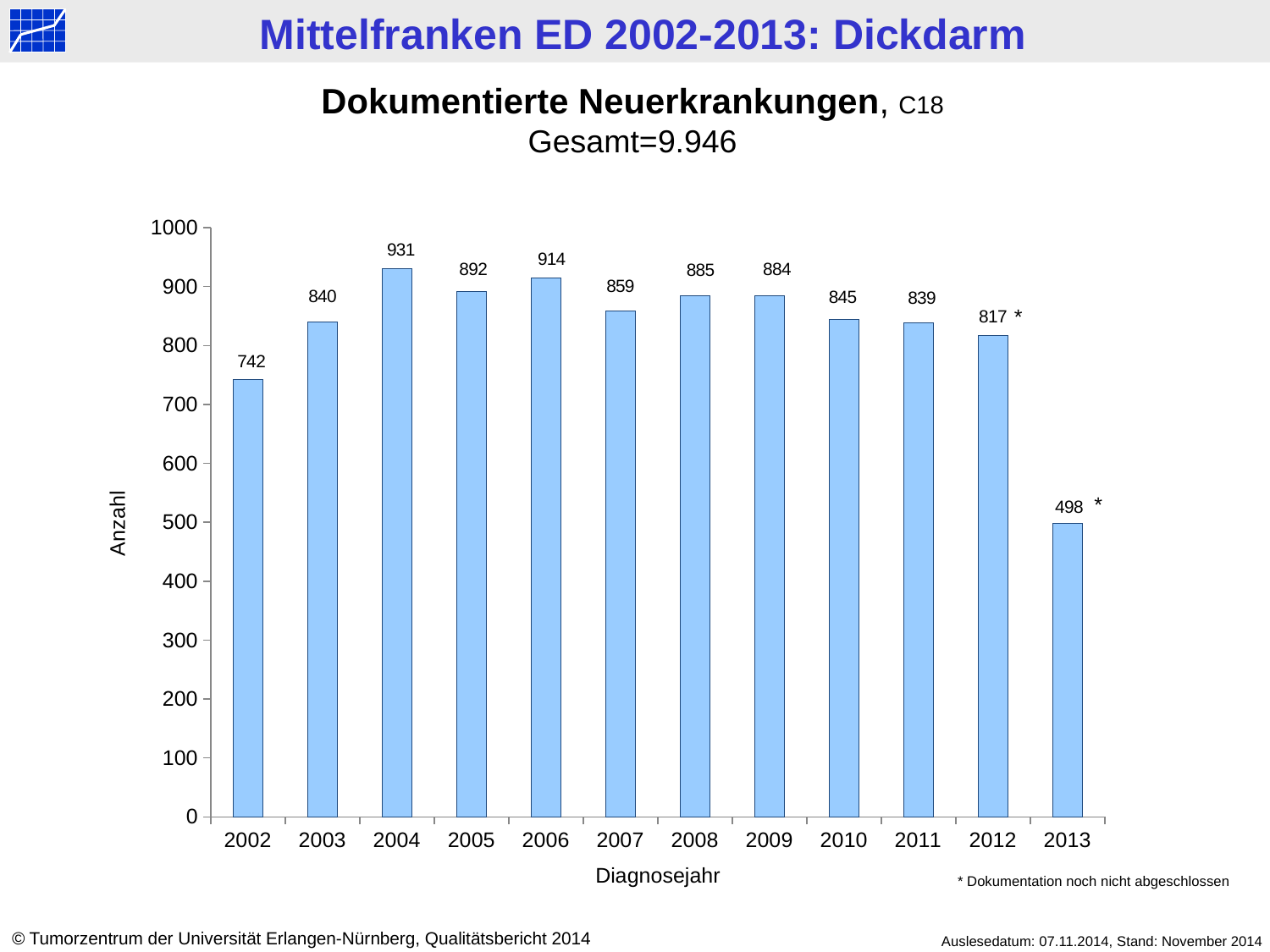
What is the value for 2002? 742 What is the label of the y axis? Anzahl Is the value for 2012 greater or less than 800? greater Which is larger, the value for 2006 or the value for 2007? 2006 What is the value for 2013? 498 What is the difference between the values for 2004 and 2002? 189 What is the value for 2004? 931 Which year has the highest value? 2004 Do the values rise or fall from 2009 to 2013? fall What kind of chart is shown? bar chart How many years are shown on the x axis? 12 Which year has the lowest value? 2013